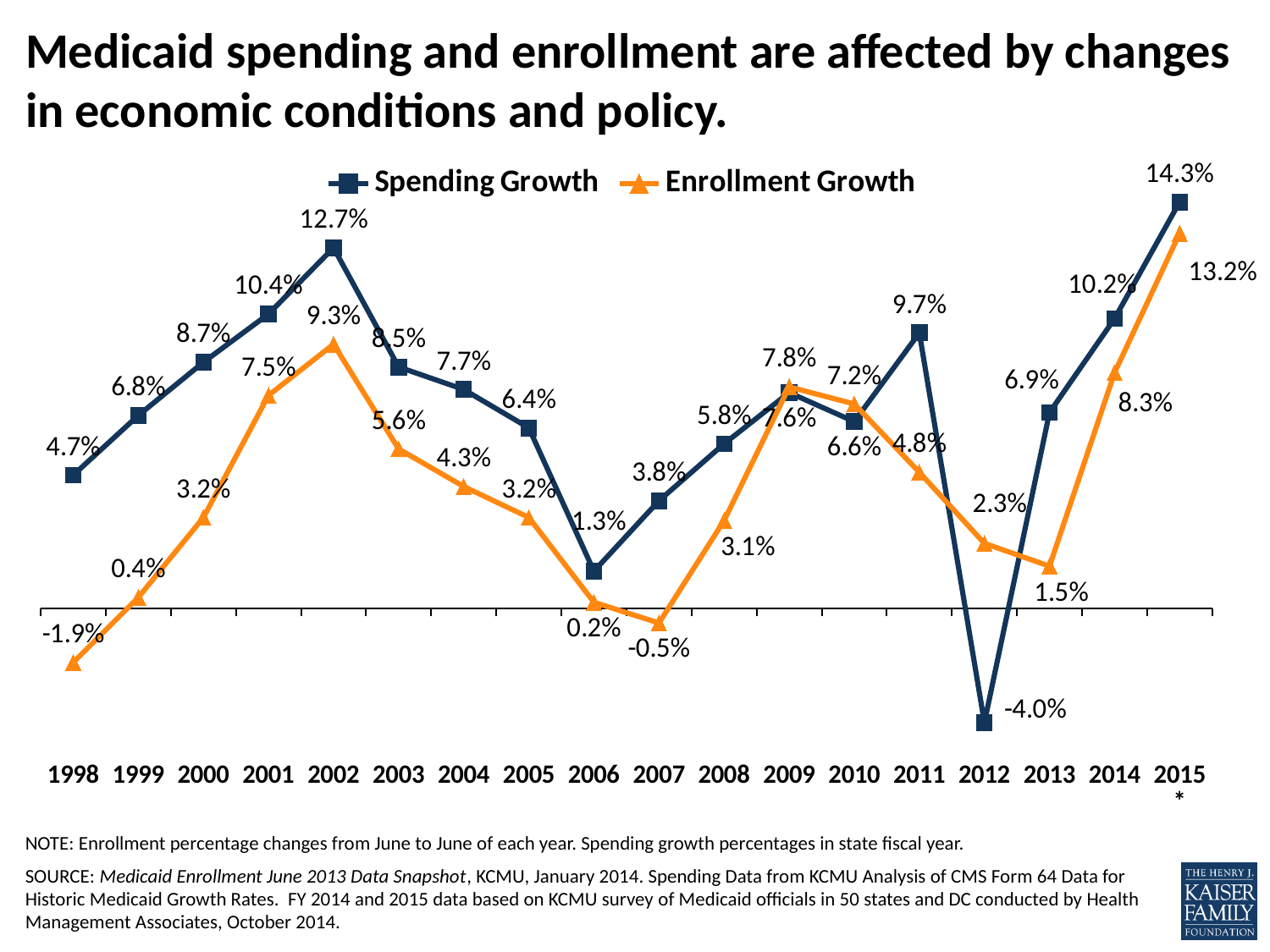
What kind of chart is shown on the slide? Line chart What is the Enrollment Growth value for 2015? 13.2% In which year is Enrollment Growth lowest? 1998 In which year is Spending Growth highest? 2015 What is the Spending Growth value for 2002? 12.7% In 2010, which is larger: Spending Growth or Enrollment Growth? Enrollment Growth What is the Enrollment Growth value for 2007? -0.5% How many years are shown on the x axis? 18 What is the difference between Spending Growth and Enrollment Growth in 2015? 1.1 percentage points How many series does the legend list? 2 In which year is Spending Growth lowest? 2012 What is the difference between Enrollment Growth and Spending Growth in 2012? 6.3 percentage points